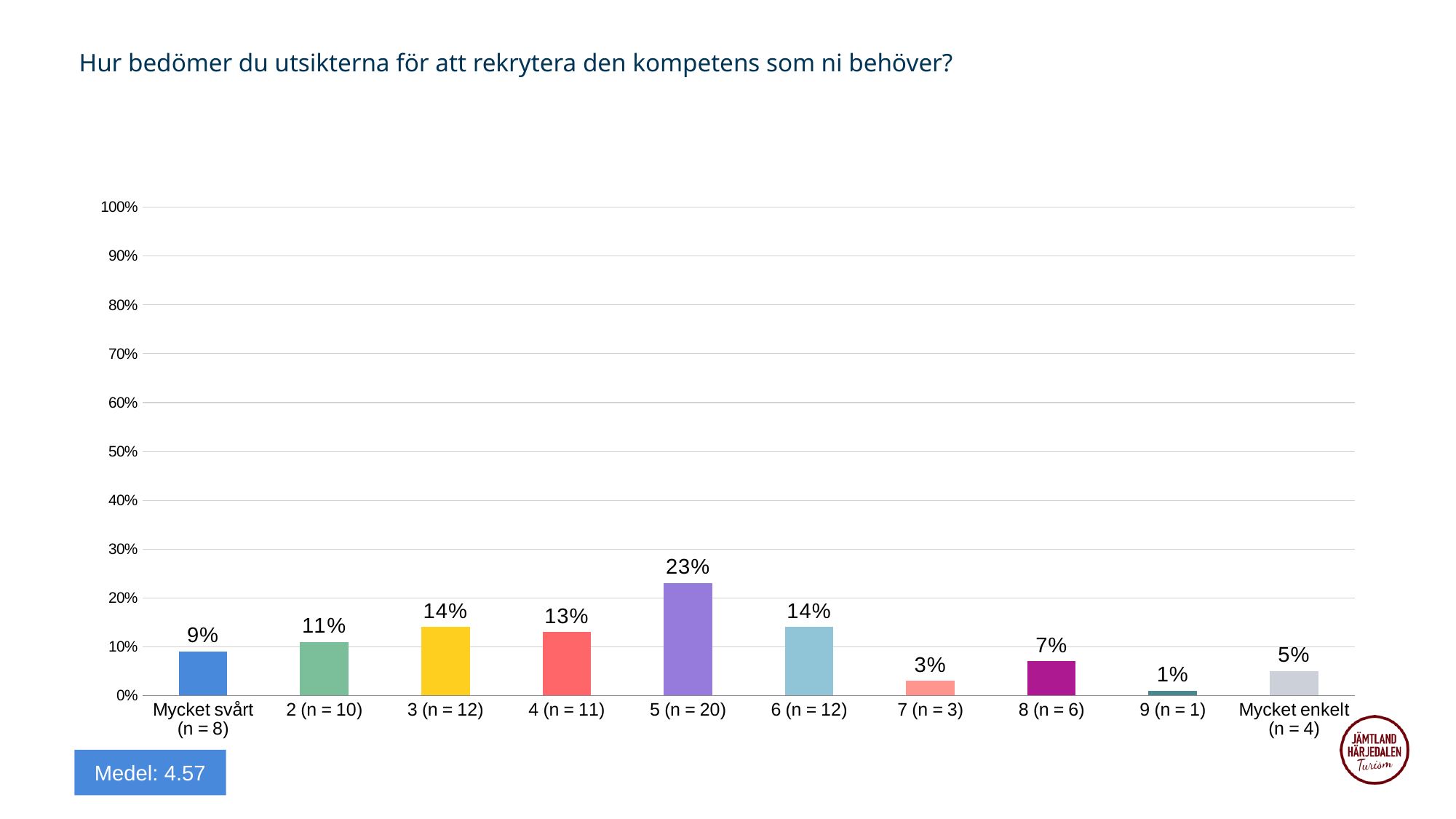
What kind of chart is shown on the slide? bar chart Which category has the highest value? 5 (n = 20) Which category has the lowest value? 9 (n = 1) What is the difference between the values for "5 (n = 20)" and "6 (n = 12)"? 9% How many categories are shown on the x axis? 10 What mean value (Medel) is shown on the slide? 4.57 Which is larger, the value for "2 (n = 10)" or the value for "8 (n = 6)"? 2 (n = 10) What is the value for the category "Mycket enkelt (n = 4)"? 5% What is the title of the chart? Hur bedömer du utsikterna för att rekrytera den kompetens som ni behöver? Is the value for "5 (n = 20)" greater or less than 20%? greater What is the value for the category "Mycket svårt (n = 8)"? 9% What is the value for the category "5 (n = 20)"? 23%